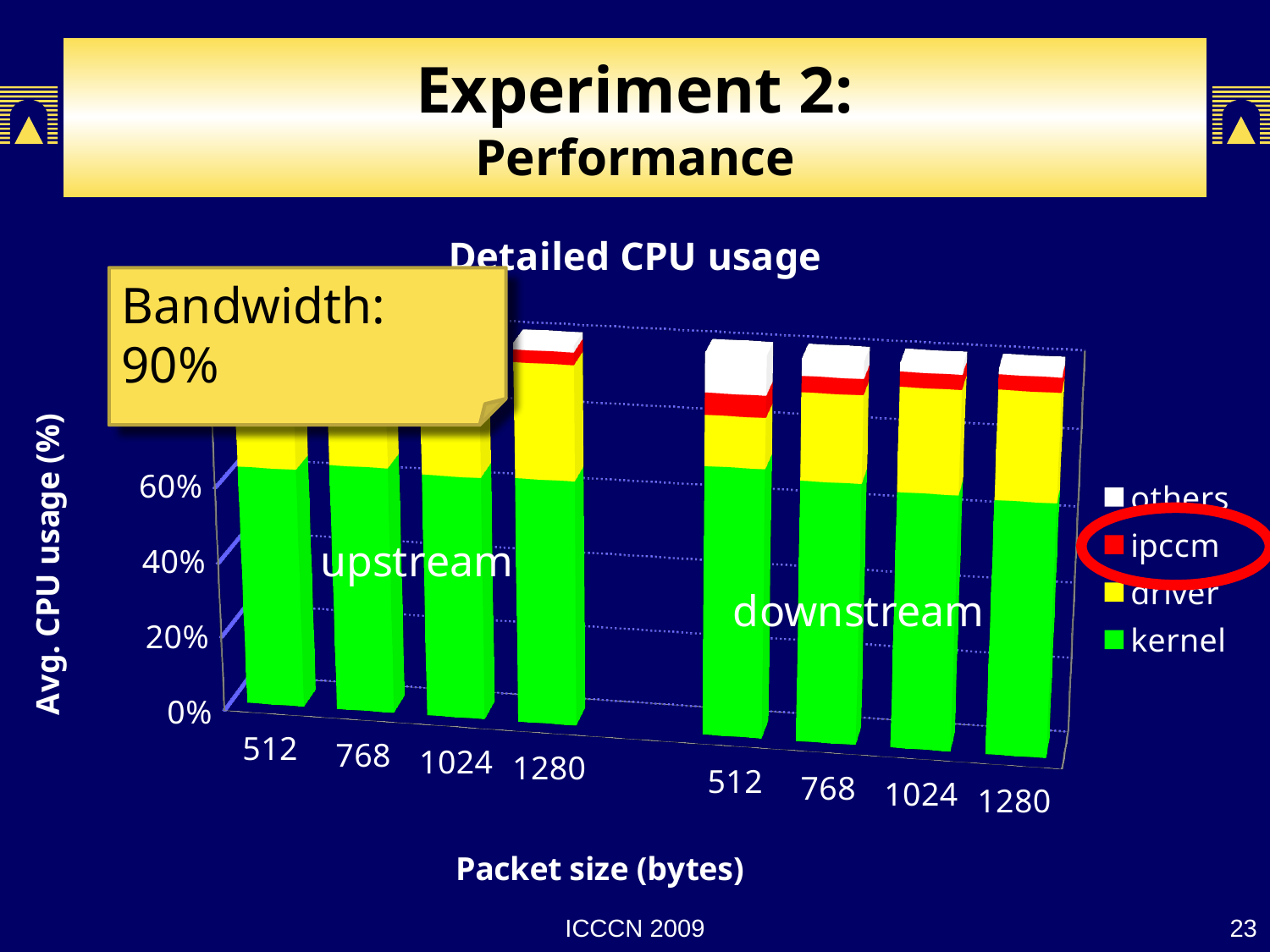
Is the total CPU usage for the downstream 512-byte bar greater or less than 80%? greater Which series forms the bottom segment of each stacked bar? kernel What is the label of the y axis? Avg. CPU usage (%) How many packet sizes are shown for the upstream group? 4 What is the label of the x axis? Packet size (bytes) Is the total CPU usage for the downstream 512-byte bar greater or less than 60%? greater Is the total CPU usage for the upstream 1280-byte bar greater or less than 60%? greater What kind of chart is shown on the slide? stacked bar chart How many series does the chart legend list? 4 What is the title of the chart? Detailed CPU usage Which legend entry is circled in red on the slide? ipccm How many bars are plotted in the chart? 8